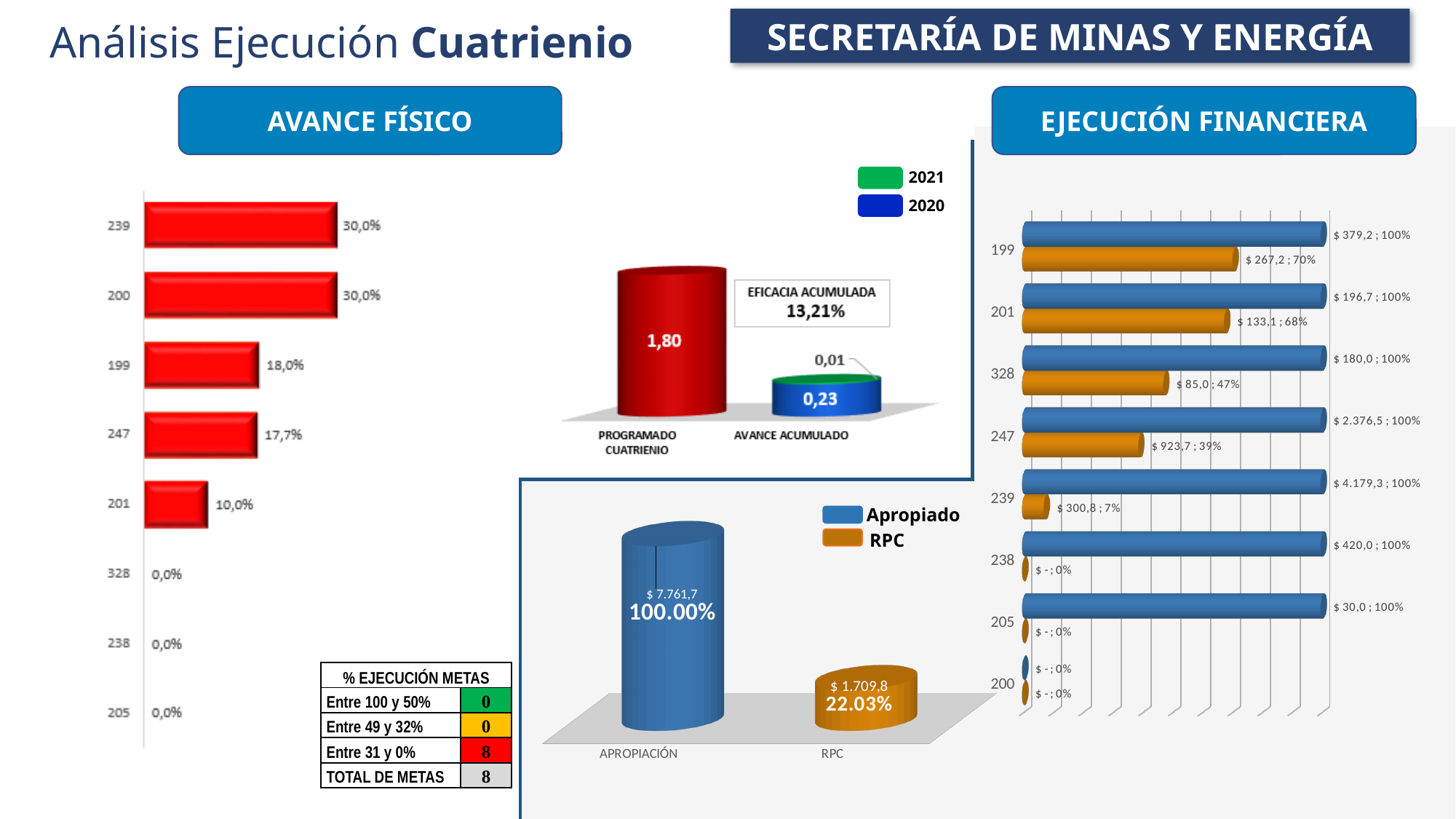
In the bottom-middle cylinder chart, what percentage is shown for RPC? 22.03% In the red horizontal bar chart on the left under AVANCE FÍSICO, what is the difference between the values for 200 and 247? 12,3% In the red horizontal bar chart on the left under AVANCE FÍSICO, what is the value for category 199? 18,0% In the red horizontal bar chart on the left under AVANCE FÍSICO, what is the value for category 201? 10,0% In the red horizontal bar chart on the left under AVANCE FÍSICO, how many categories are plotted? 8 In the bottom-middle cylinder chart, what amount is shown for APROPIACIÓN? $ 7.761,7 In the cylinder chart in the middle of the slide, what is the EFICACIA ACUMULADA shown? 13,21% In the horizontal bar chart on the right under EJECUCIÓN FINANCIERA, what is the RPC value for category 328? $ 85,0 ; 47% In the horizontal bar chart on the right under EJECUCIÓN FINANCIERA, what is the Apropiado value for category 247? $ 2.376,5 ; 100% In the cylinder chart in the middle of the slide, what is the value for PROGRAMADO CUATRIENIO? 1,80 In the horizontal bar chart on the right under EJECUCIÓN FINANCIERA, how many series does the legend list? 2